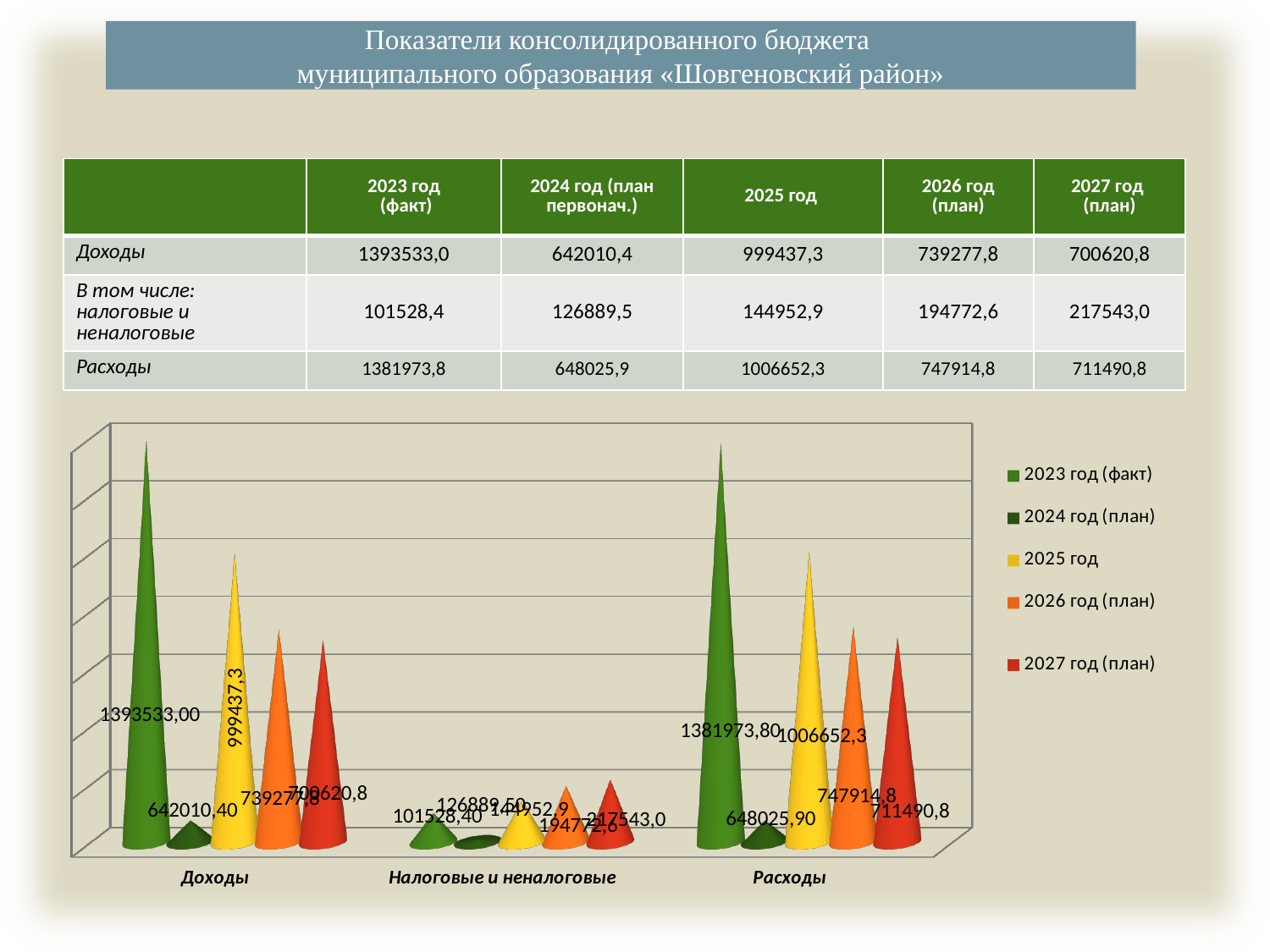
Which series has the highest value for Расходы? 2023 год (факт) What is the value for Налоговые и неналоговые in the 2023 год (факт) series? 101528,40 What is the difference between Доходы and Расходы in the 2023 год (факт) series? 11559,20 What is the value for Доходы in the 2023 год (факт) series? 1393533,00 What is the value for Налоговые и неналоговые in the 2027 год (план) series? 217543,0 Which is larger in the 2025 год series: Доходы or Налоговые и неналоговые? Доходы How many categories are shown on the x axis of the chart? 3 Which series has the lowest value for Доходы? 2024 год (план) What kind of chart is shown on the slide? bar chart What is the value for Расходы in the 2025 год series? 1006652,3 How many series does the chart legend list? 5